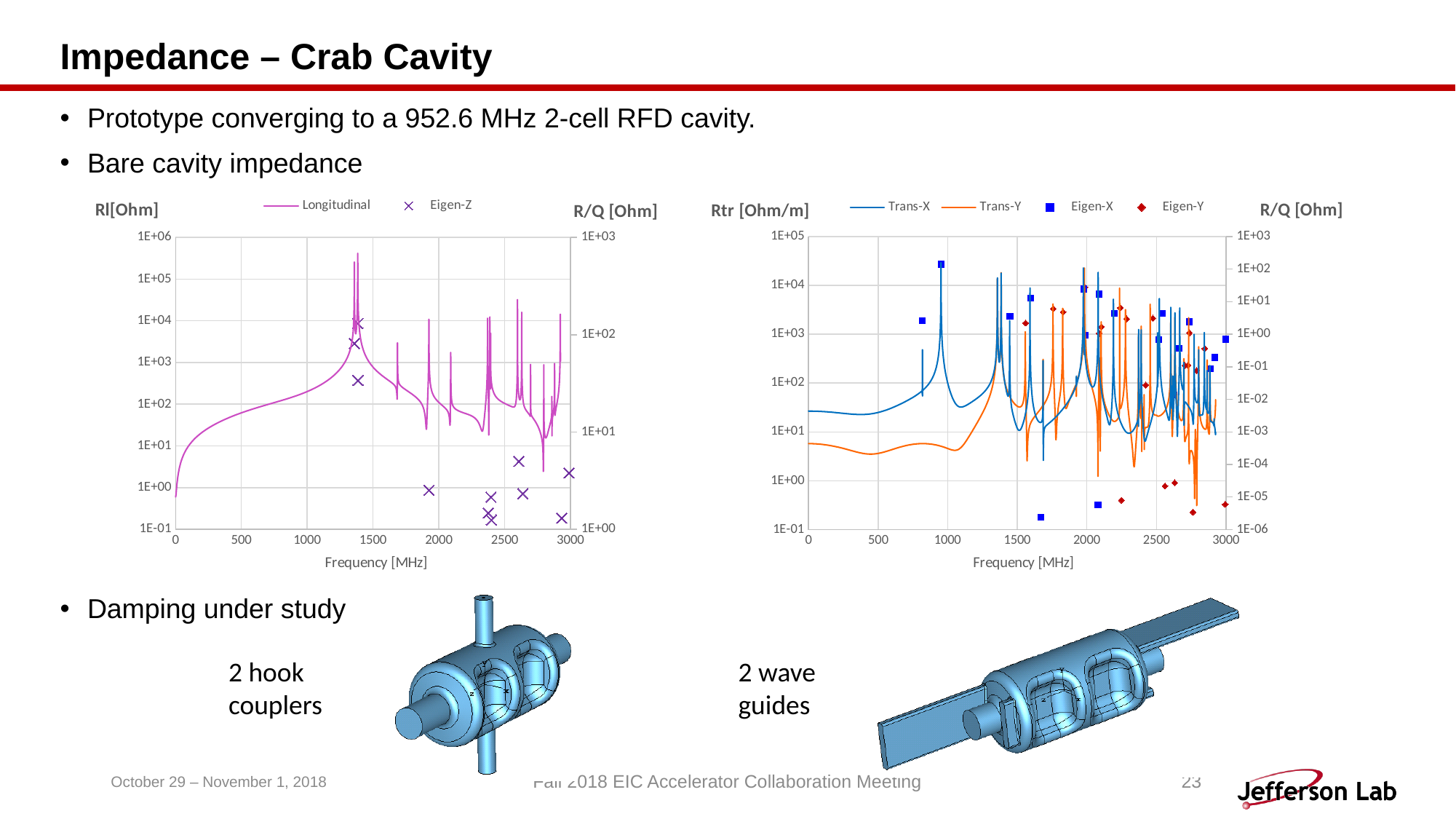
In the left chart (Rl[Ohm]), does the Longitudinal series rise or fall between 0 MHz and 1000 MHz? rise In the right chart (Rtr [Ohm/m]), is the Trans-X value at 0 MHz greater or less than 1E+01? greater In the left chart (Rl[Ohm]), is the highest peak of the Longitudinal series greater or less than 1E+05? greater In the right chart (Rtr [Ohm/m]), is the Trans-Y value at 0 MHz greater or less than 1E+01? less What are the legend entries of the right chart (Rtr [Ohm/m])? Trans-X, Trans-Y, Eigen-X, Eigen-Y How many series does the legend of the left chart (Rl[Ohm]) list? 2 What is the maximum frequency shown on the x axis of the right chart (Rtr [Ohm/m])? 3000 In the right chart (Rtr [Ohm/m]), which series has the larger value at 0 MHz, Trans-X or Trans-Y? Trans-X How many series does the legend of the right chart (Rtr [Ohm/m]) list? 4 What kind of chart is the left chart (Rl[Ohm])? Line chart What is the x-axis title of the left chart (Rl[Ohm])? Frequency [MHz]